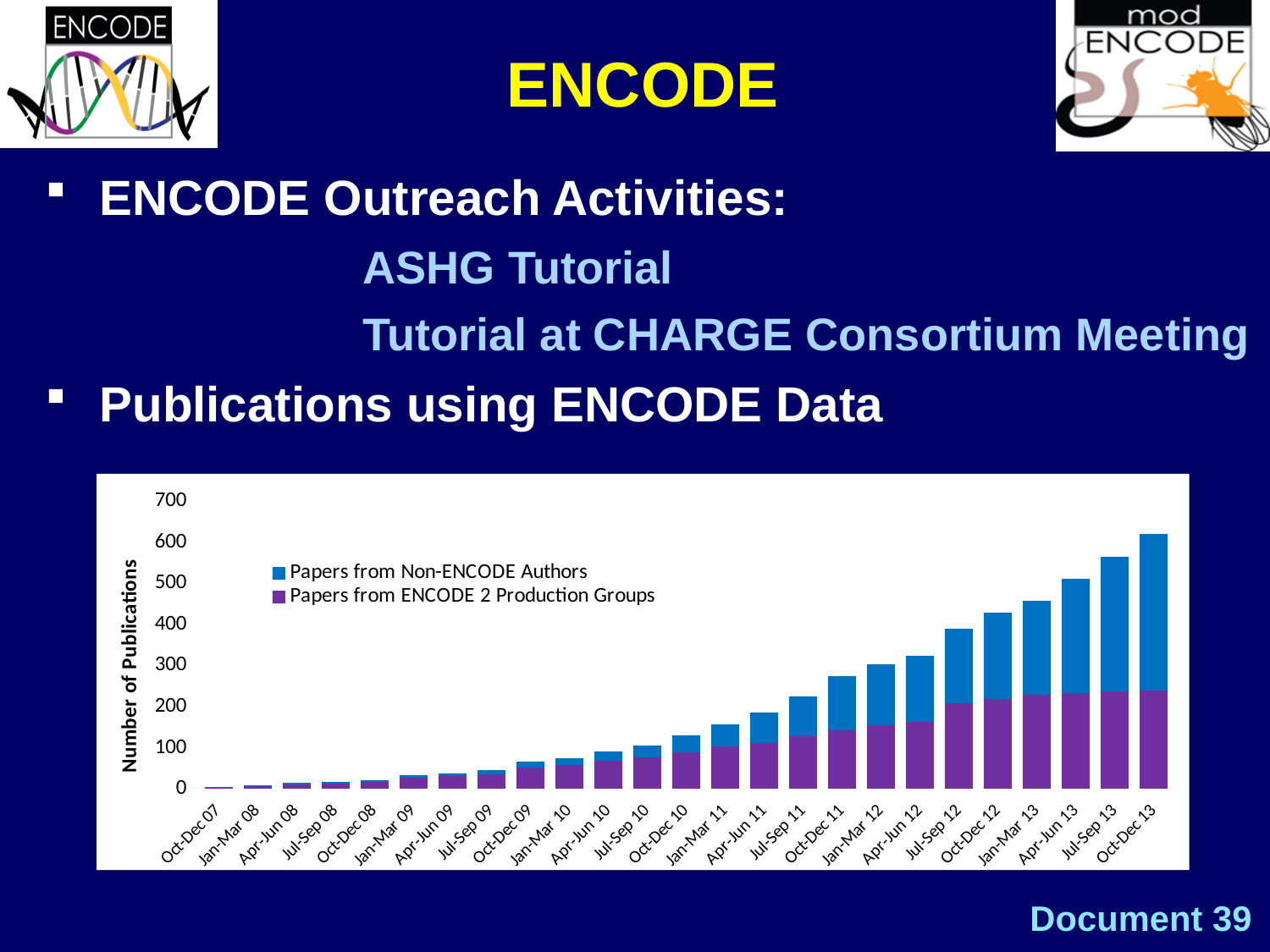
How many series does the chart legend list? 2 How many quarterly categories are shown along the x axis of the chart? 25 Is the total number of publications for Oct-Dec 11 greater or less than 300? less Which quarter has the lowest total number of publications? Oct-Dec 07 Which quarter has a larger total number of publications, Oct-Dec 12 or Jan-Mar 12? Oct-Dec 12 Is the total number of publications for Oct-Dec 13 greater or less than 600? greater Which quarter has the highest total number of publications? Oct-Dec 13 What is the label of the vertical axis of the chart? Number of Publications What kind of chart is shown on the slide? Stacked bar chart What are the two series named in the chart legend? Papers from Non-ENCODE Authors; Papers from ENCODE 2 Production Groups Do the total publication counts rise or fall from Oct-Dec 07 to Oct-Dec 13? Rise